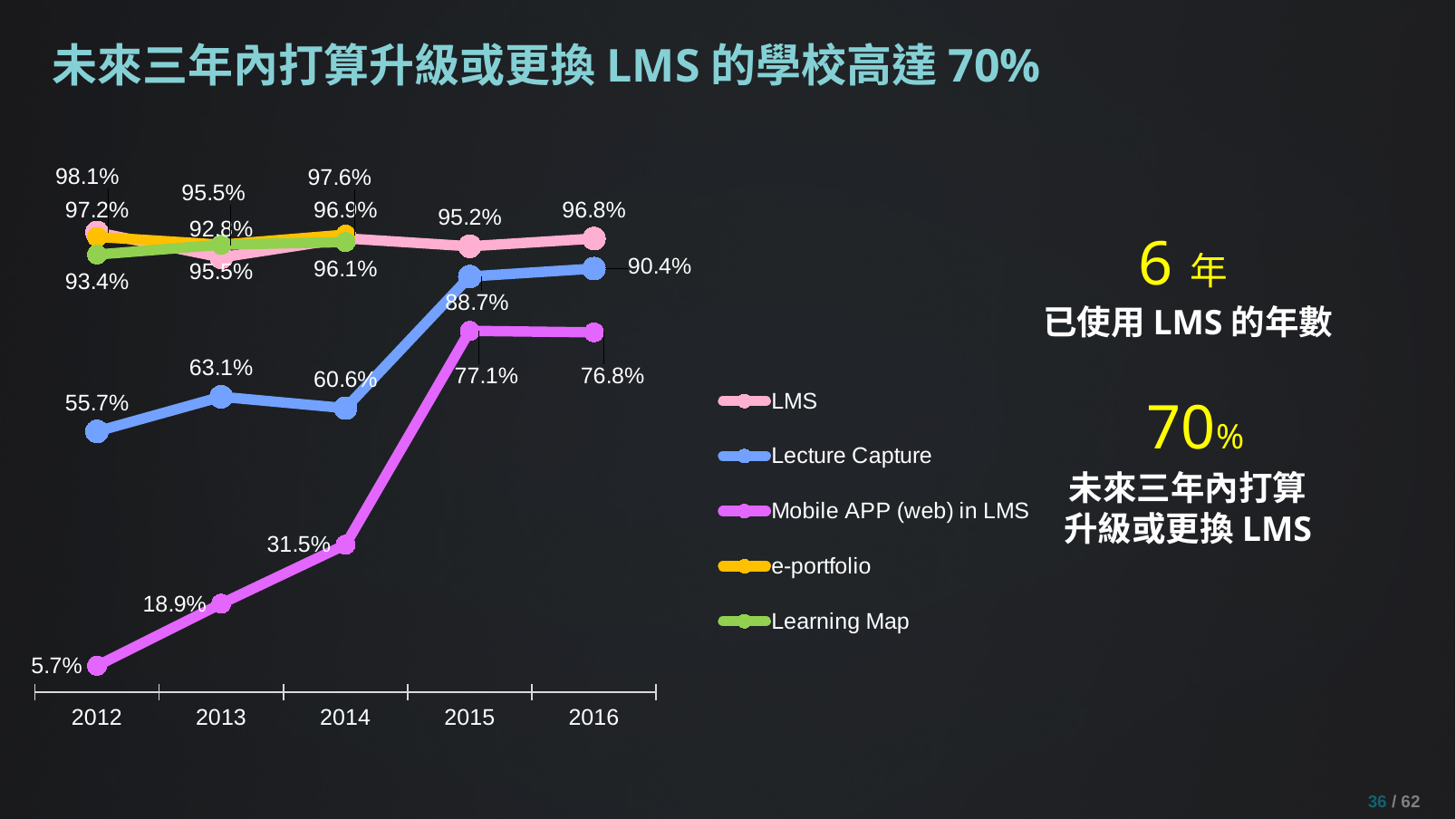
In which year is the Lecture Capture value highest? 2016 Does the Mobile APP (web) in LMS line rise or fall from 2012 to 2015? Rises What is the value for Mobile APP (web) in LMS in 2012? 5.7% What is the value for Lecture Capture in 2016? 90.4% What colour is the Lecture Capture line in the legend? Blue How many years are shown on the x axis? 5 What is the value for Learning Map in 2012? 93.4% What is the value for LMS in 2016? 96.8% What kind of chart is shown on the slide? Line chart How many series does the legend list? 5 Which year has the higher Lecture Capture value, 2013 or 2014? 2013 What is the difference between the Mobile APP (web) in LMS values for 2015 and 2014? 45.6 percentage points